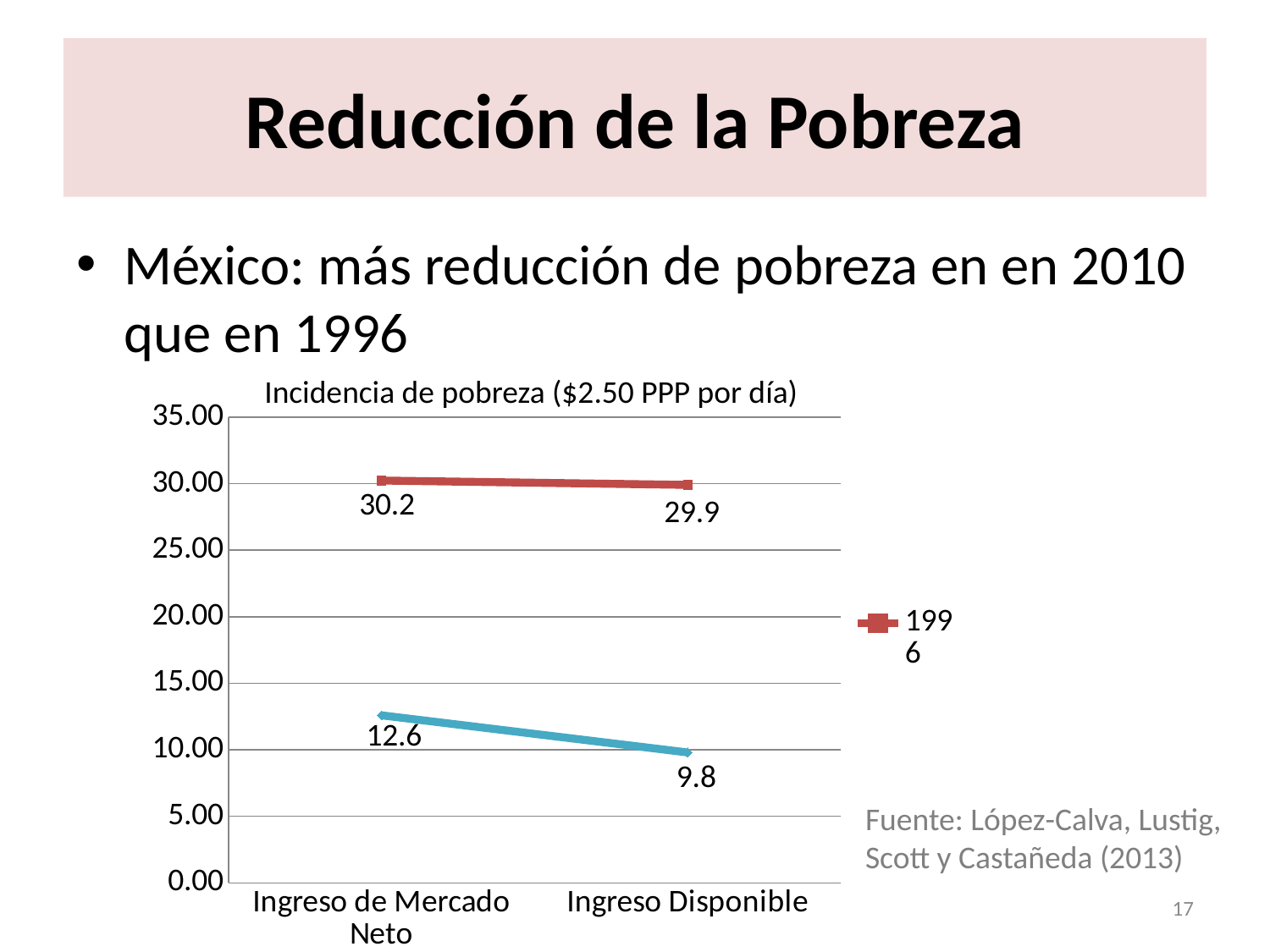
What is the value of the blue line for Ingreso Disponible? 9.8 What kind of chart is shown on the slide? line chart Which is larger for Ingreso Disponible: the 1996 value or the blue line's value? 1996 Is the blue line's value for Ingreso Disponible greater or less than 10.00? less What is the title of the chart? Incidencia de pobreza ($2.50 PPP por día) What is the value of the 1996 series for Ingreso Disponible? 29.9 Does the blue line rise or fall from Ingreso de Mercado Neto to Ingreso Disponible? fall What is the value of the 1996 series for Ingreso de Mercado Neto? 30.2 What is the difference between the 1996 values for Ingreso de Mercado Neto and Ingreso Disponible? 0.3 What is the difference between the blue line's values for Ingreso de Mercado Neto and Ingreso Disponible? 2.8 How many categories are shown on the x axis? 2 What is the value of the blue line for Ingreso de Mercado Neto? 12.6